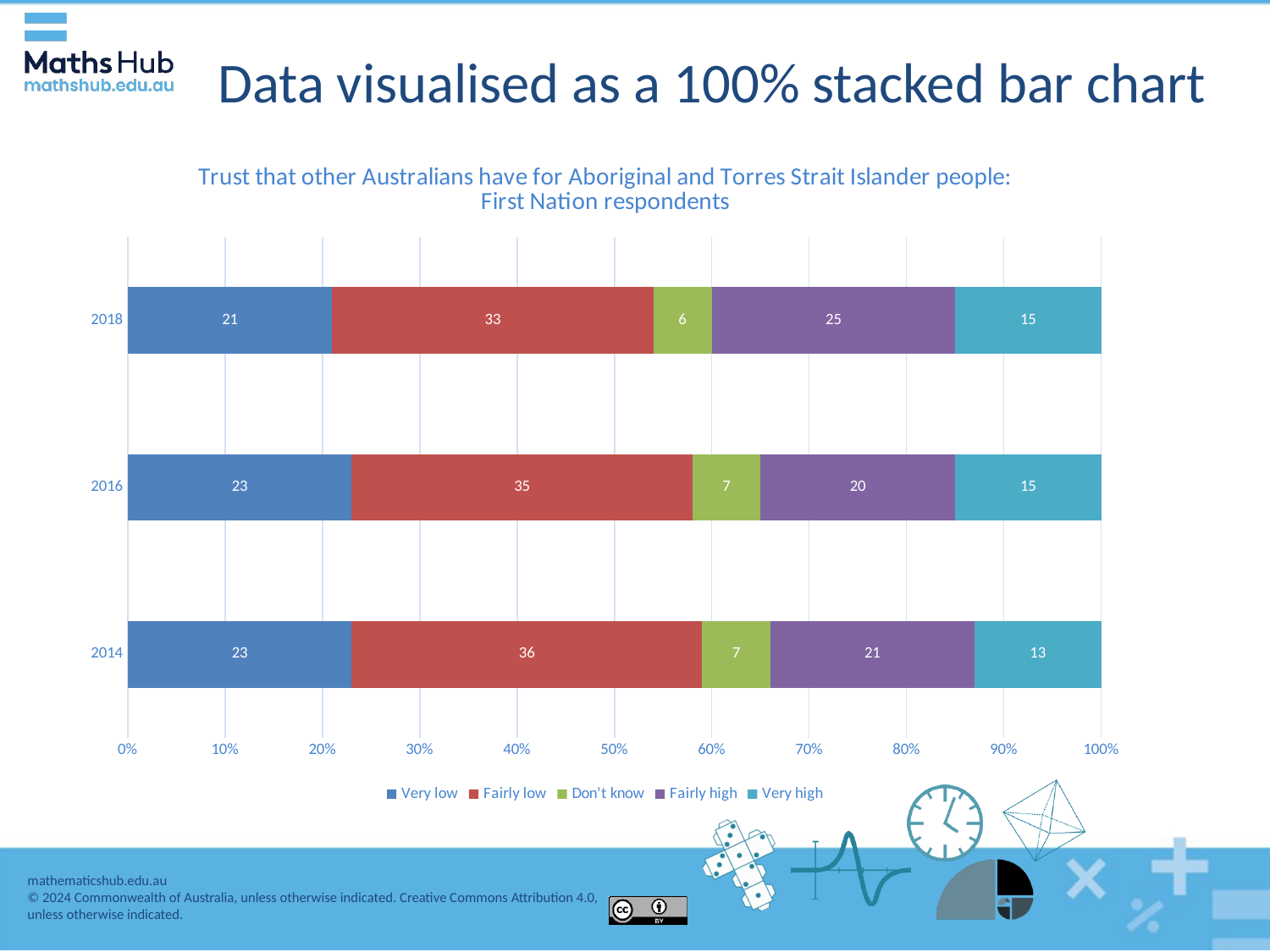
What kind of chart is shown on the slide? 100% stacked bar chart Which legend entry is shown in green? Don't know What is the value for 'Don't know' in 2016? 7 How many series does the legend list? 5 What is the value for 'Fairly low' in 2018? 33 What is the difference between the 'Fairly low' values for 2014 and 2018? 3 Which year has the highest value for 'Fairly high'? 2018 Is the 'Very low' value larger in 2016 or in 2018? 2016 Which year has the lowest value for 'Fairly low'? 2018 What is the total of the stacked bar for 2016? 100 How many years are shown on the chart? 3 What is the value for 'Very high' in 2014? 13